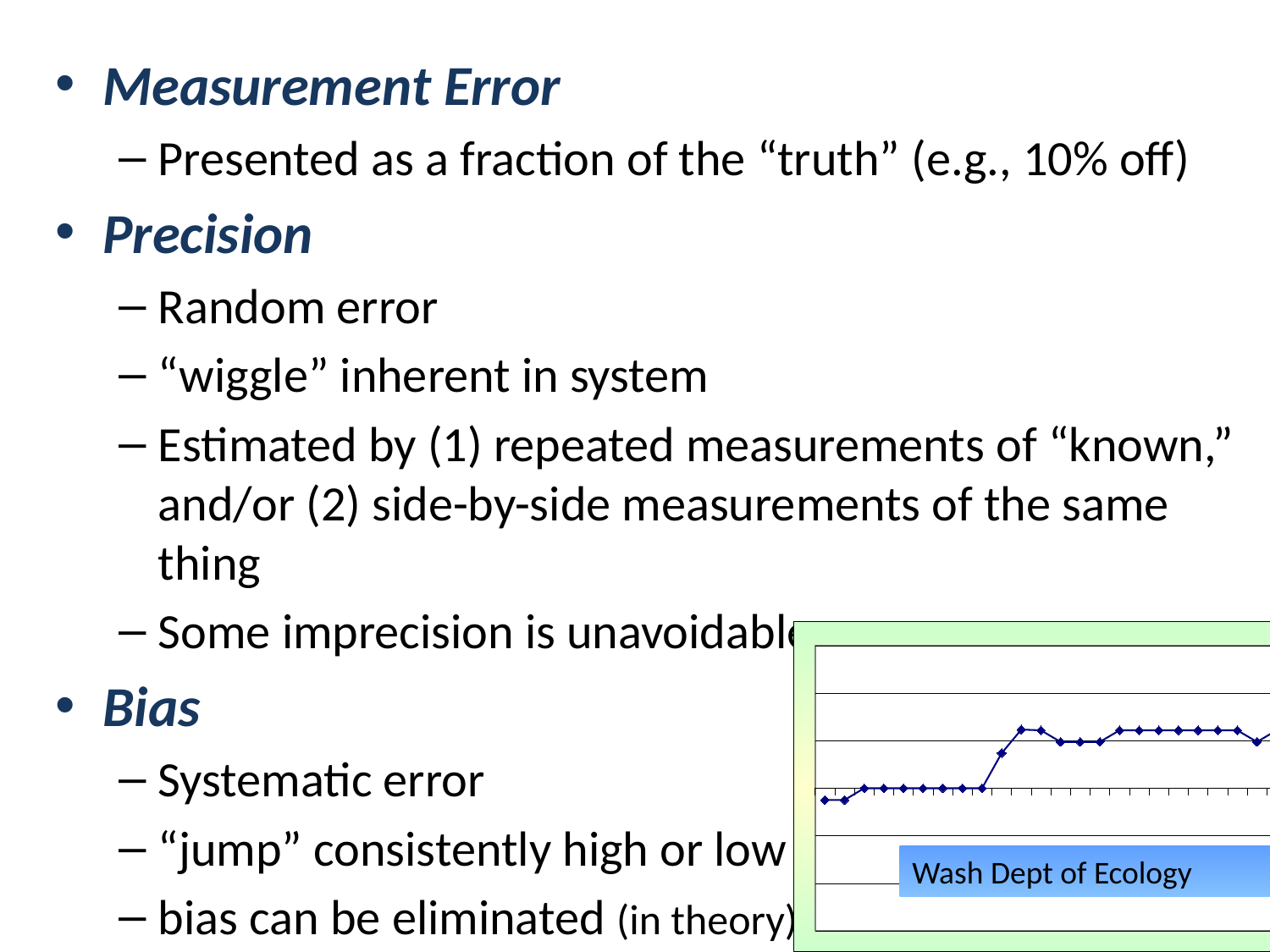
Do the plotted values rise or fall from left to right along the x axis? rise What text appears in the box inside the chart? Wash Dept of Ecology What kind of chart is shown on the slide? line chart What colour is the plotted line in the chart? blue